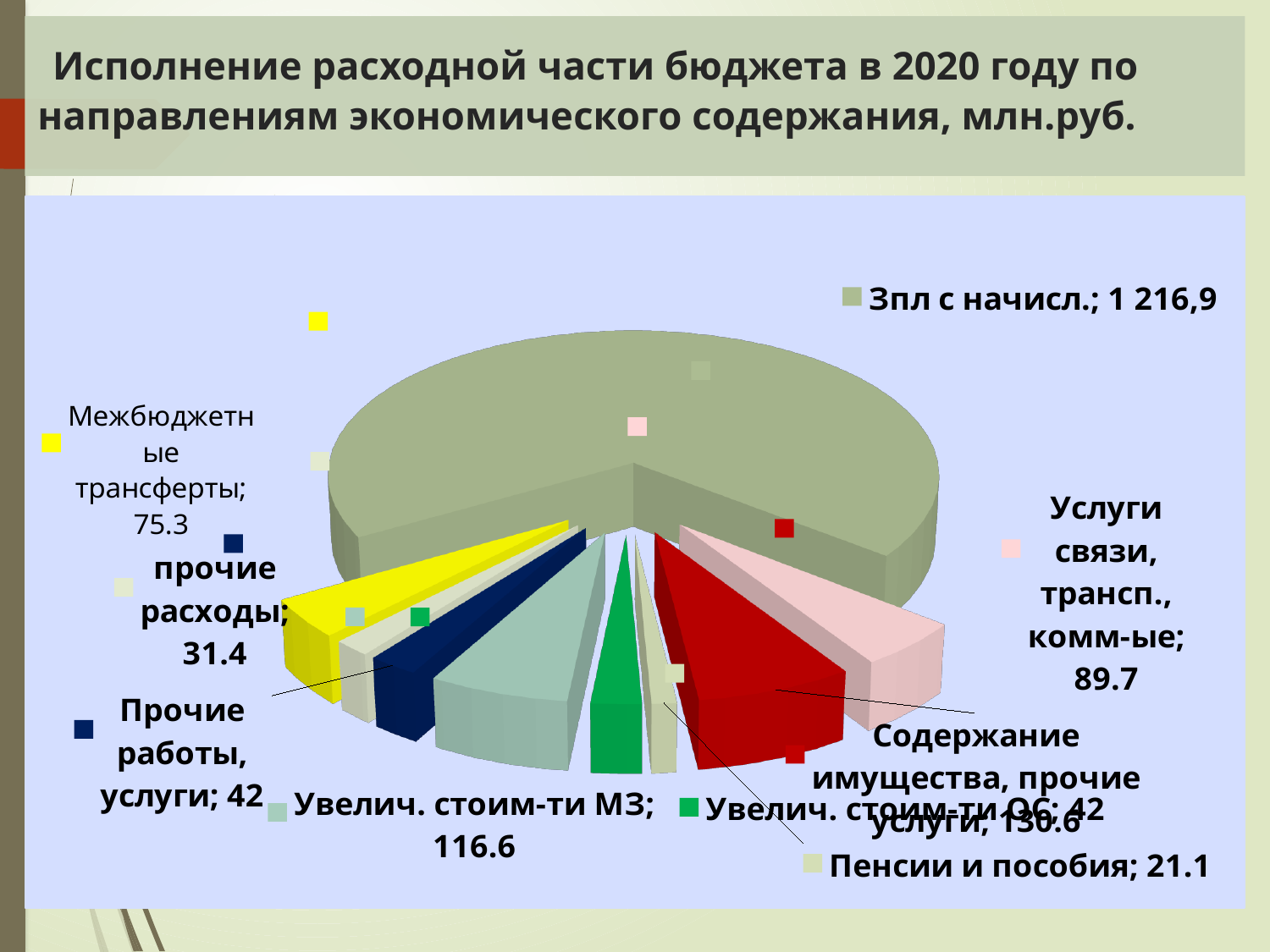
What is the value for Увелич. стоим-ти МЗ? 116.6 What is the value for Пенсии и пособия? 21.1 What is the difference between Содержание имущества, прочие услуги and Увелич. стоим-ти МЗ? 14.0 What is the value for Межбюджетные трансферты? 75.3 Which is larger: Услуги связи, трансп., комм-ые or Межбюджетные трансферты? Услуги связи, трансп., комм-ые How many categories does the pie chart show? 9 What is the value for Зпл с начисл.? 1 216,9 What unit of measurement is stated in the slide title? млн.руб. What kind of chart is shown on the slide? Pie chart Which category has the largest value? Зпл с начисл. What is the value for Услуги связи, трансп., комм-ые? 89.7 Which category has the smallest value? Пенсии и пособия